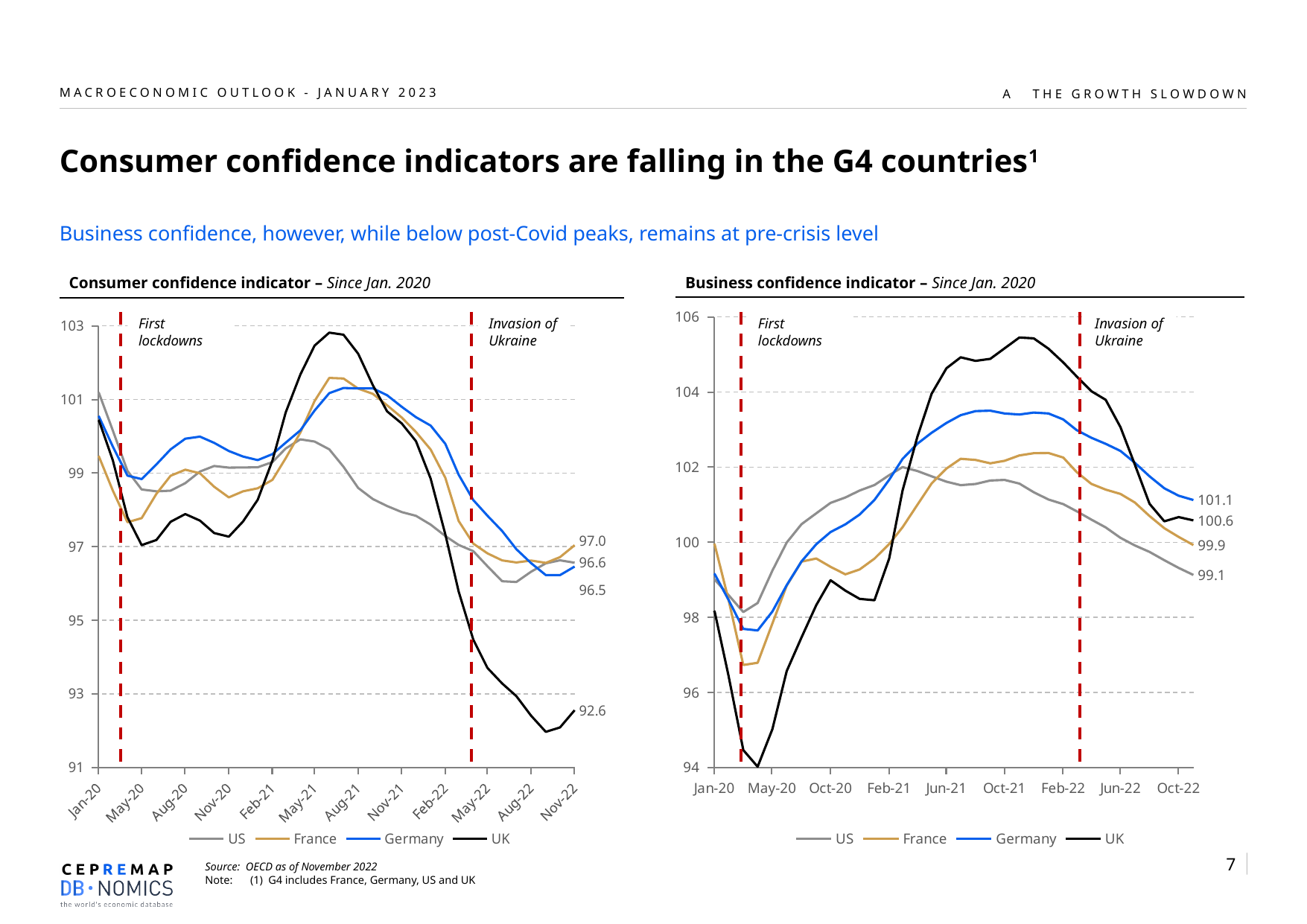
How many series does the legend of the Business confidence indicator chart list? 4 In the Consumer confidence indicator chart, what is the latest value shown for France? 97.0 What kind of chart is the Consumer confidence indicator chart? Line chart What two events do the red dashed vertical lines mark on the charts? First lockdowns and Invasion of Ukraine In the Business confidence indicator chart, what is the latest value shown for Germany? 101.1 In the Consumer confidence indicator chart, what is the latest value shown for the UK? 92.6 In the Business confidence indicator chart, what is the latest value shown for the UK? 100.6 In the Business confidence indicator chart, what is the latest value shown for the US? 99.1 In the Business confidence indicator chart, which country has the highest latest value? Germany In the Consumer confidence indicator chart, is the UK's peak value in 2021 greater or less than 102? greater In the Consumer confidence indicator chart, which country has the lowest latest value? UK In the Business confidence indicator chart, what is the difference between the latest values for Germany and the US? 2.0